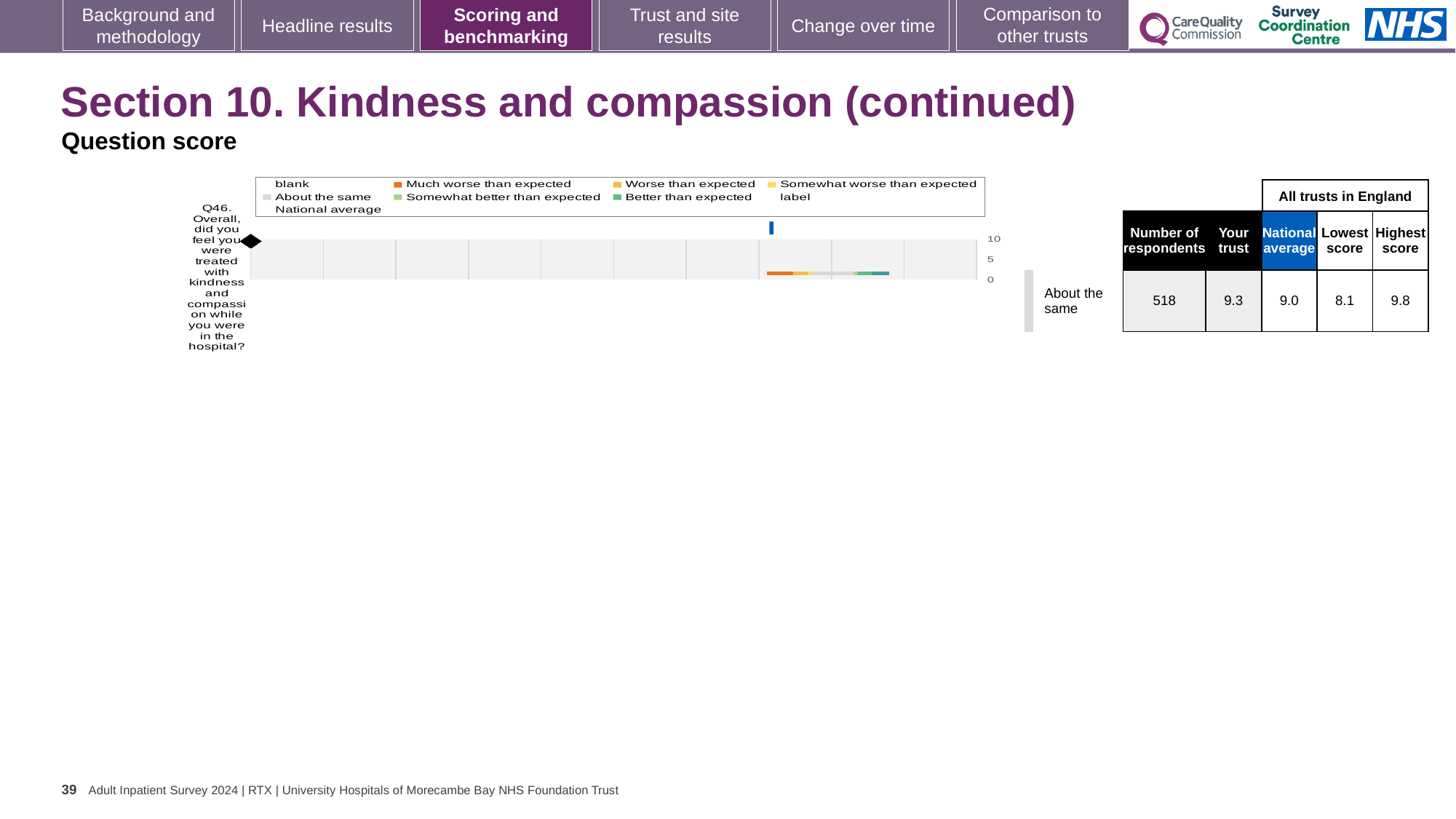
In the table beside the chart, what is the Lowest score among all trusts in England for Q46? 8.1 What kind of chart is shown on the slide? bar chart Is the 'Your trust' score for Q46 larger or smaller than the National average? larger How many questions (categories) are plotted on the chart? 1 In the table beside the chart, what is the National average for Q46? 9.0 In the table beside the chart, what is the Number of respondents for Q46? 518 What is the difference between the Highest score and the Lowest score for Q46 in the table beside the chart? 1.7 In the table beside the chart, what is the Highest score among all trusts in England for Q46? 9.8 What benchmark category is given for Q46 next to the chart? About the same Which question is plotted on the chart? Q46. Overall, did you feel you were treated with kindness and compassion while you were in the hospital? In the table beside the chart, what is the 'Your trust' score for Q46? 9.3 What is the highest value shown on the chart's axis? 10